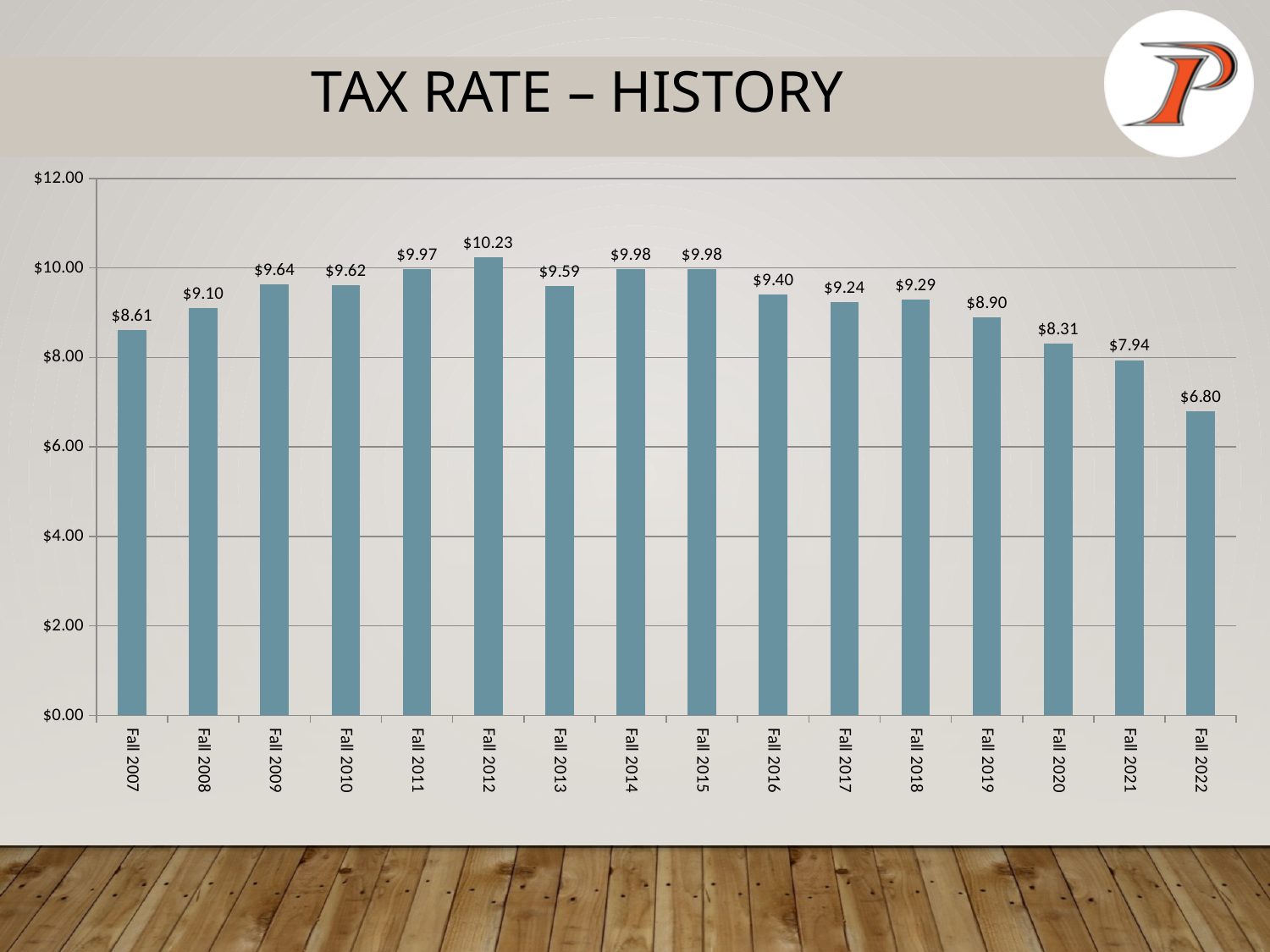
What is the tax rate for Fall 2007? $8.61 Which year has the highest tax rate? Fall 2012 How many years are shown on the chart? 16 What kind of chart is shown on the slide? bar chart Which year has the lowest tax rate? Fall 2022 What is the tax rate for Fall 2022? $6.80 What is the difference between the tax rate in Fall 2012 and Fall 2022? $3.43 Is the tax rate for Fall 2021 greater or less than $8.00? less What is the title of the slide? TAX RATE – HISTORY Do the tax rates rise or fall from Fall 2015 to Fall 2022? fall What is the tax rate for Fall 2012? $10.23 Which is larger, the tax rate for Fall 2009 or Fall 2010? Fall 2009